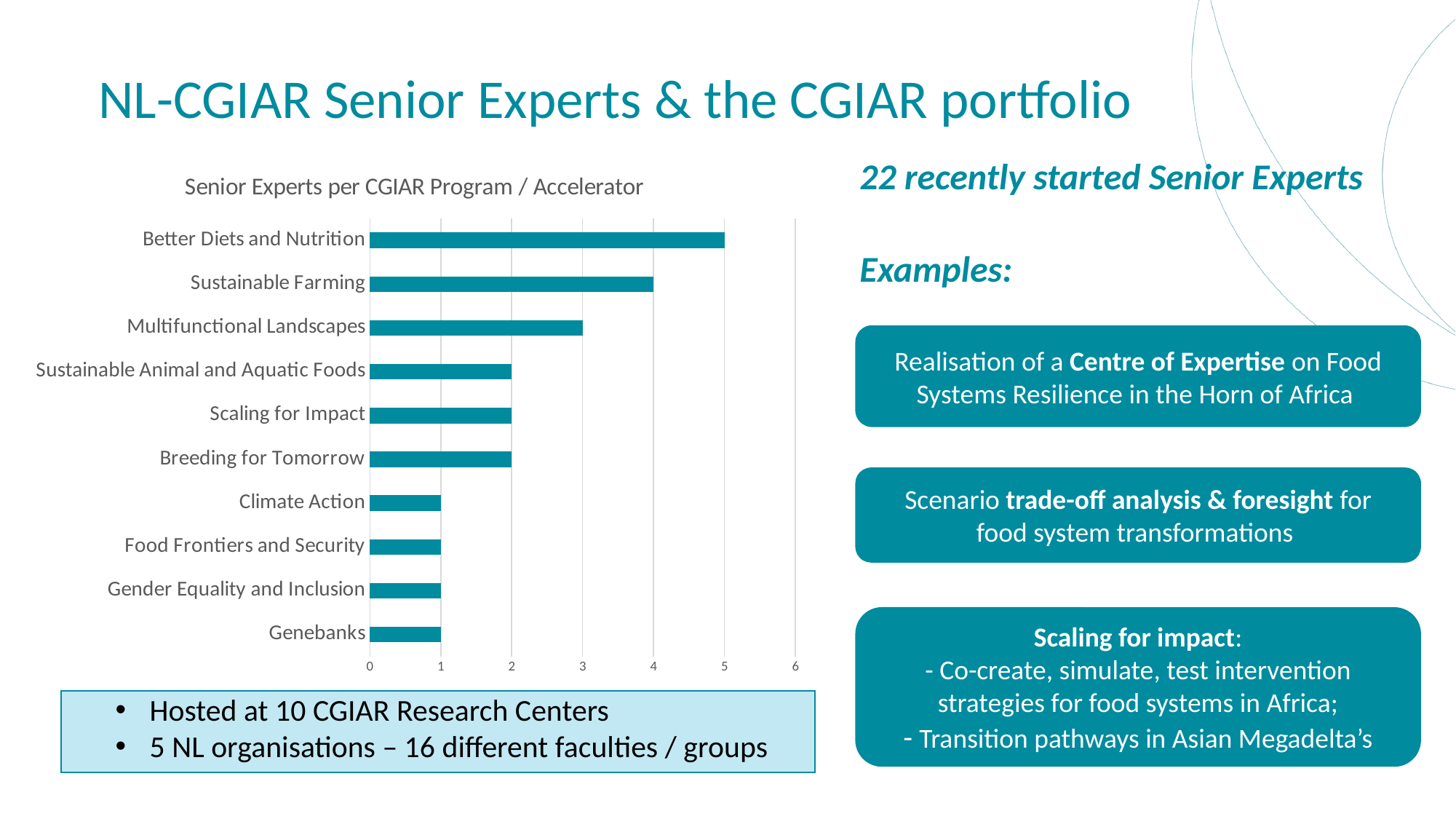
How many Senior Experts does Sustainable Farming have? 4 How many Senior Experts does Multifunctional Landscapes have? 3 What is the difference in Senior Experts between Better Diets and Nutrition and Sustainable Farming? 1 Which has more Senior Experts, Multifunctional Landscapes or Breeding for Tomorrow? Multifunctional Landscapes How many Senior Experts does Scaling for Impact have? 2 What type of chart is shown on the slide? Bar chart What is the title of the chart? Senior Experts per CGIAR Program / Accelerator Which program has the highest number of Senior Experts? Better Diets and Nutrition How many Senior Experts does Genebanks have? 1 Is the value for Better Diets and Nutrition greater or less than 4? greater How many programs / accelerators are listed in the chart? 10 How many Senior Experts does Better Diets and Nutrition have? 5